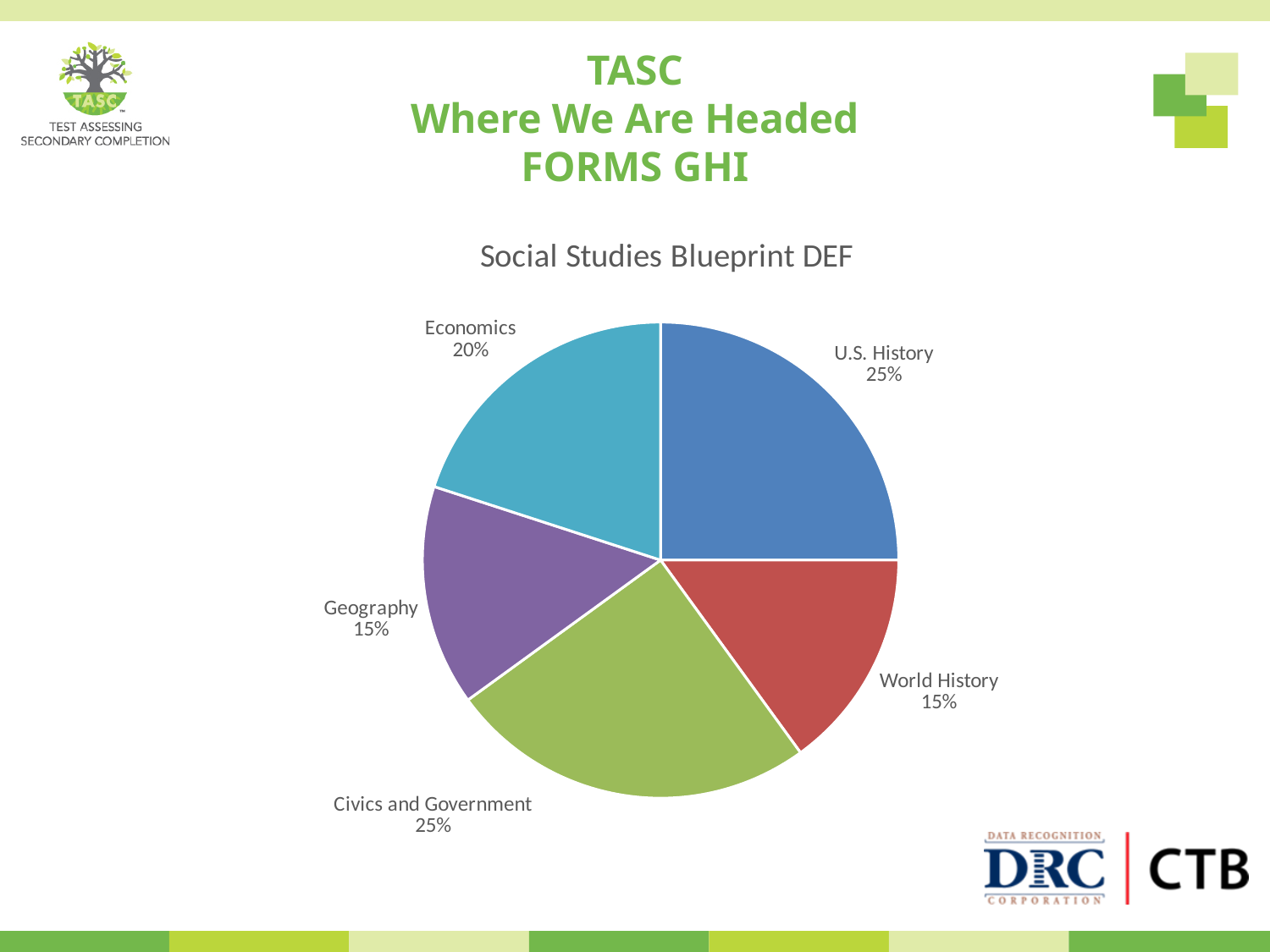
Which two categories share the smallest slice of the pie? Geography and World History What colour is the U.S. History slice? blue What share of the pie does Geography represent? 15% What is the title of the chart? Social Studies Blueprint DEF What share of the pie does Economics represent? 20% What type of chart is shown on the slide? pie chart What share of the pie does World History represent? 15% What is the difference between the share for U.S. History and the share for World History? 10% How many slices does the pie chart have? 5 What share of the pie does Civics and Government represent? 25% What is the difference between the share for Civics and Government and the share for Economics? 5% Which is larger, the share for Economics or the share for Geography? Economics